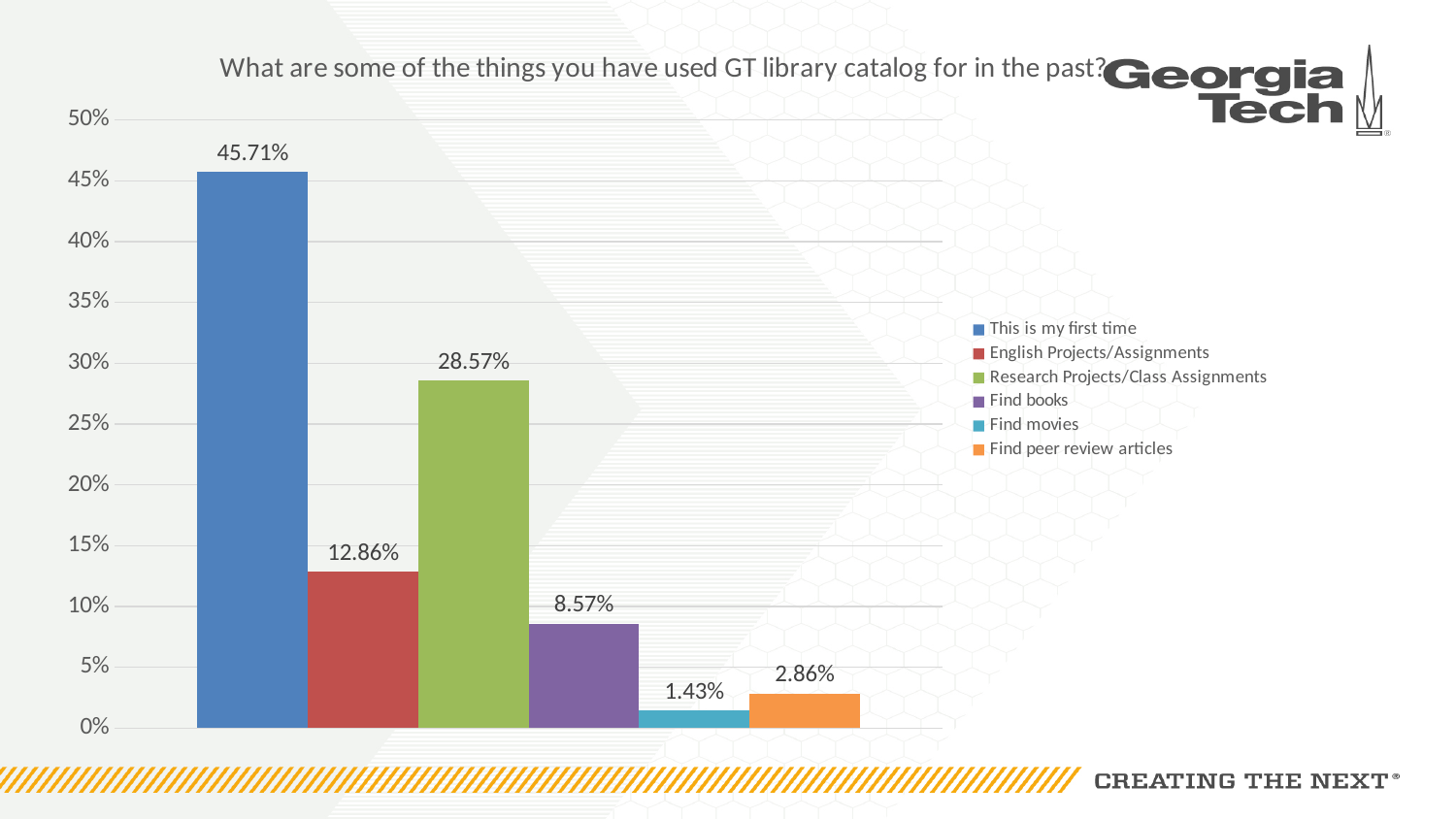
What percentage of respondents said "This is my first time"? 45.71% Which is larger, "English Projects/Assignments" or "Find books"? English Projects/Assignments Which category has the highest value? This is my first time What colour is the bar for "Find peer review articles"? Orange What kind of chart is shown on the slide? Bar chart What is the value for "Research Projects/Class Assignments"? 28.57% What is the value for "Find movies"? 1.43% Which category has the lowest value? Find movies Is the value for "English Projects/Assignments" greater or less than 10%? greater What is the difference between "This is my first time" and "Research Projects/Class Assignments"? 17.14% How many categories are plotted in the chart? 6 What is the value for "Find peer review articles"? 2.86%